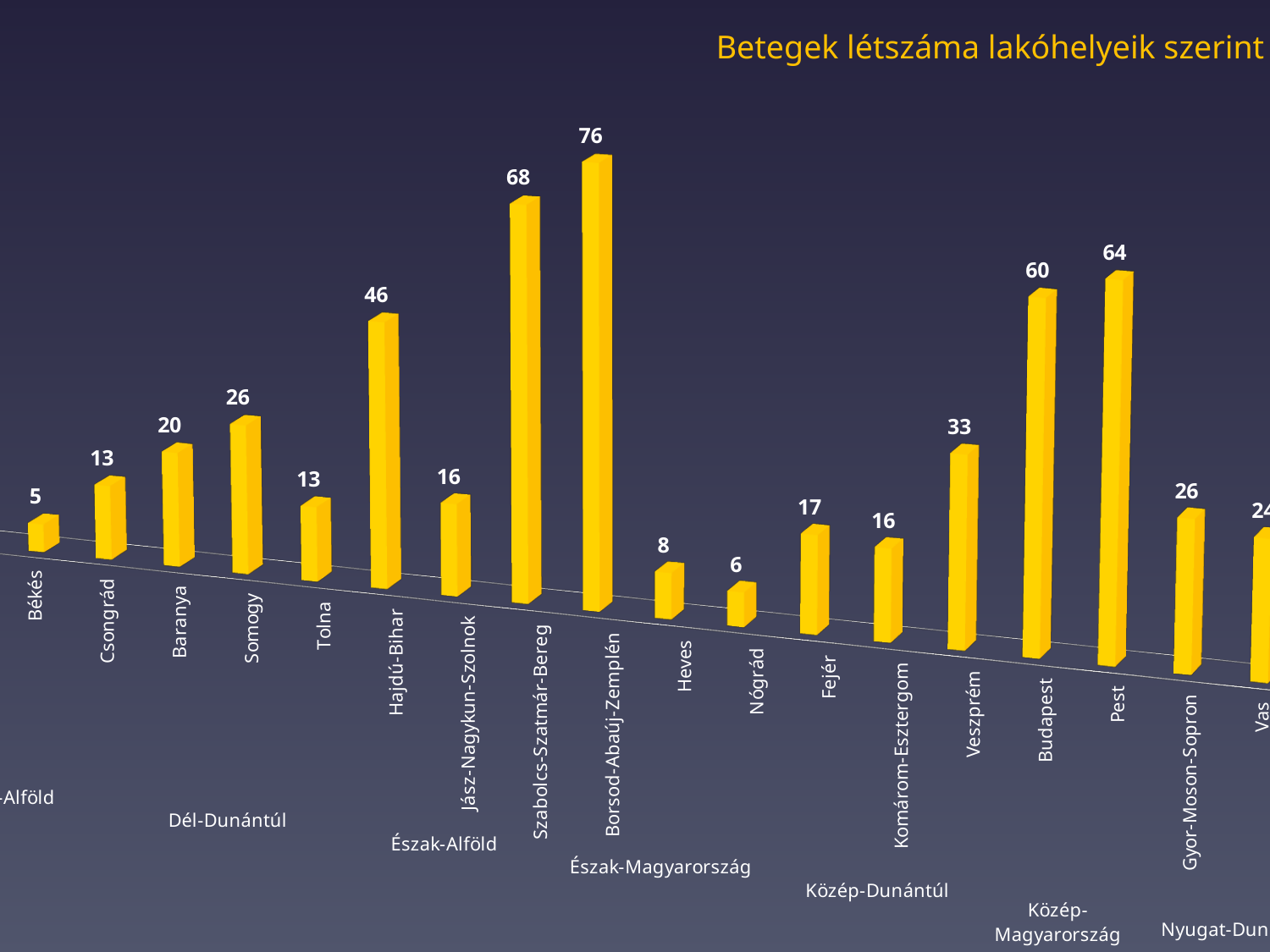
Which of the bars shown on the slide has the highest value? Borsod-Abaúj-Zemplén What kind of chart is shown on the slide? bar chart What is the value for Hajdú-Bihar? 46 What is the difference between the values for Szabolcs-Szatmár-Bereg and Hajdú-Bihar? 22 What is the difference between the values for Pest and Budapest? 4 What is the value for Veszprém? 33 What is the value for Nógrád? 6 Which is larger, the value for Somogy or the value for Baranya? Somogy What is the value for Borsod-Abaúj-Zemplén? 76 What is the value for Budapest? 60 What is the title of the chart? Betegek létszáma lakóhelyeik szerint Which of the bars shown on the slide has the lowest value? Békés